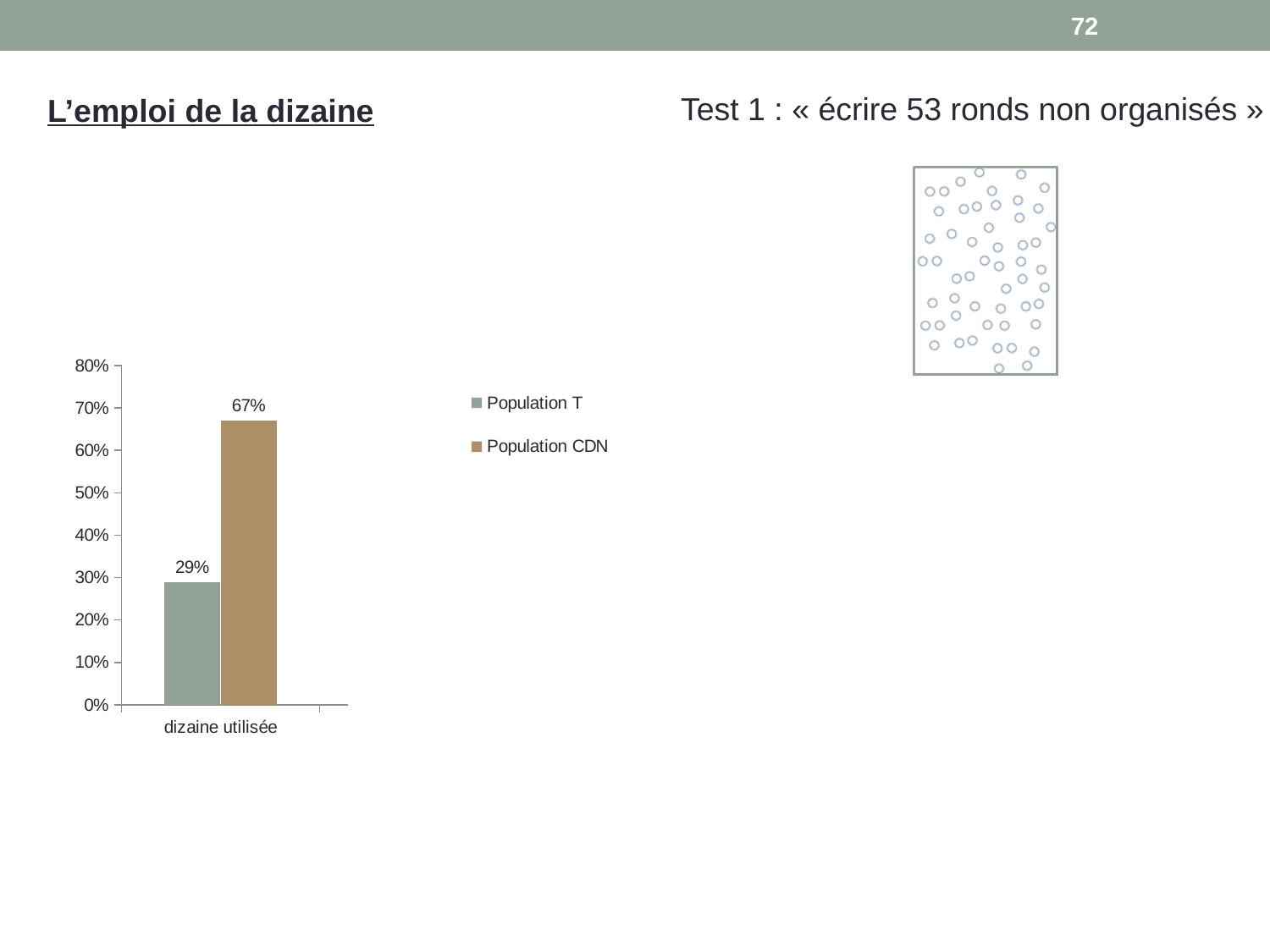
Is the value for Population T greater or less than 30%? less What is the value for Population CDN in the 'dizaine utilisée' category? 67% What is the label of the category on the x axis? dizaine utilisée Which series has the higher value for 'dizaine utilisée'? Population CDN What is the value for Population T in the 'dizaine utilisée' category? 29% What kind of chart is shown on the slide? bar chart What is the maximum value shown on the y axis? 80% Which series has the lower value for 'dizaine utilisée'? Population T How many categories are shown on the x axis? 1 Is the value for Population CDN greater or less than 60%? greater What is the difference between the Population CDN and Population T values? 38% How many series does the legend list? 2